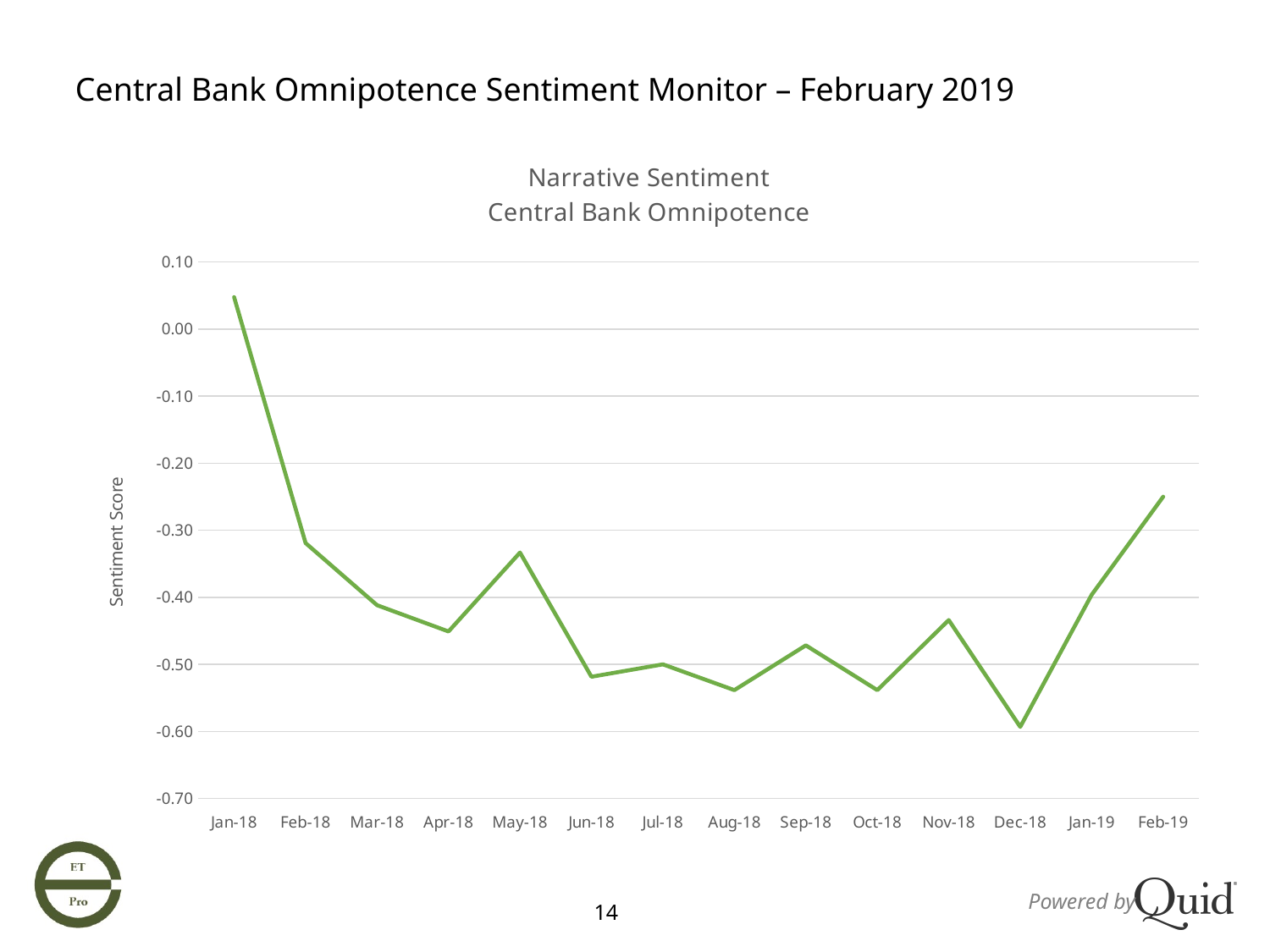
Which month has the highest sentiment score? Jan-18 What is the label on the vertical axis of the chart? Sentiment Score What kind of chart is shown on the slide? line chart Which month has the lowest sentiment score? Dec-18 Does the sentiment score rise or fall from Dec-18 to Feb-19? rise Is the sentiment score for Apr-18 greater or less than -0.40? less Which month has the higher sentiment score, Dec-18 or Jan-19? Jan-19 Is the sentiment score for Jan-18 greater or less than 0.00? greater How many monthly data points are plotted on the line? 14 Is the sentiment score for Dec-18 greater or less than -0.50? less Which month has the higher sentiment score, Apr-18 or May-18? May-18